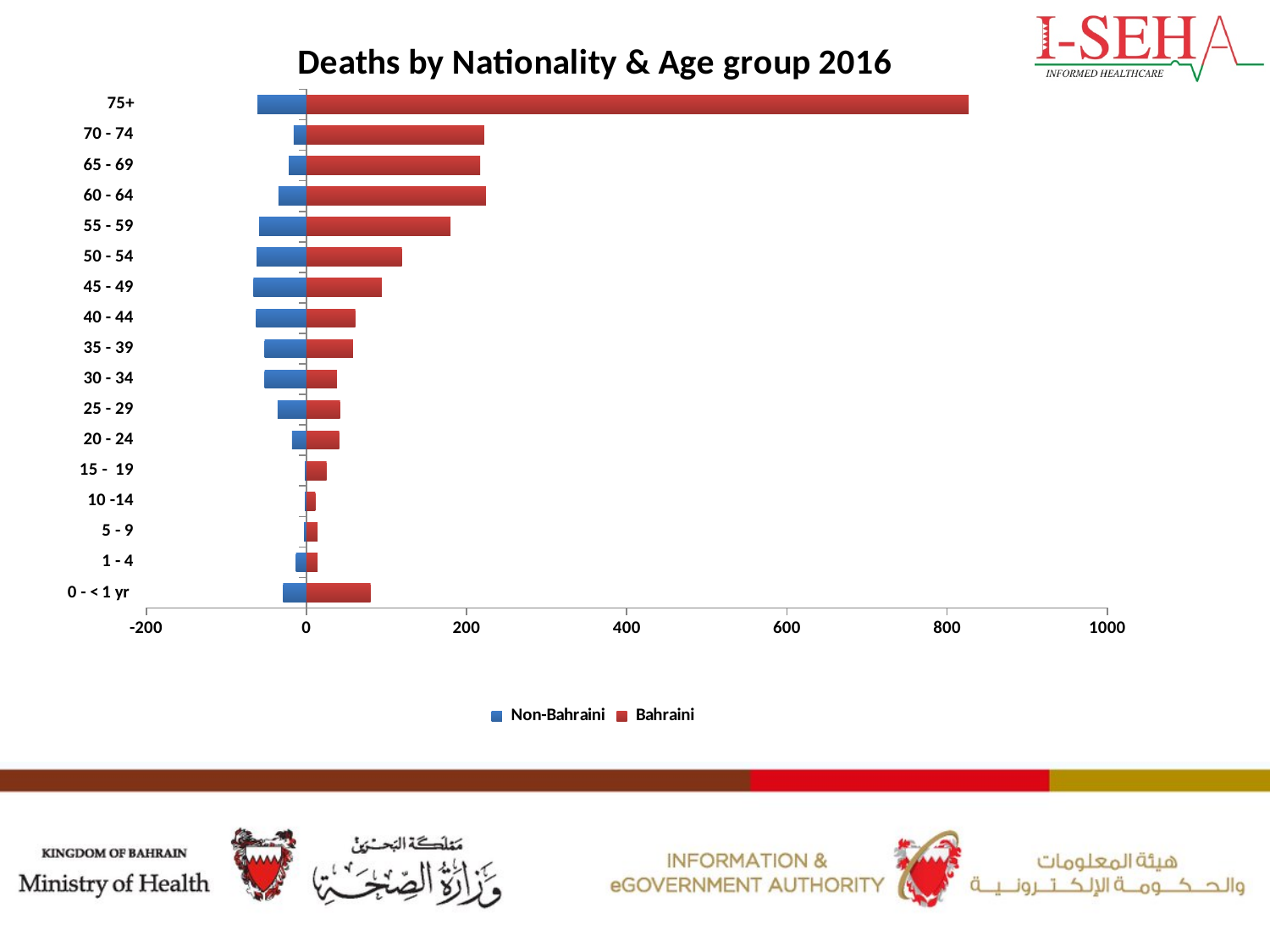
Is the Bahraini value for the 55 - 59 age group greater or less than 200? less What type of chart is shown on the slide? Bar chart Which has more Bahraini deaths, the 0 - < 1 yr age group or the 1 - 4 age group? 0 - < 1 yr How many age group categories are shown on the chart? 17 Is the Bahraini value for the 0 - < 1 yr age group greater or less than 200? less Is the Bahraini value for the 75+ age group greater or less than 800? greater How many series does the legend list? 2 Which has more Bahraini deaths, the 50 - 54 age group or the 45 - 49 age group? 50 - 54 What is the title of the chart? Deaths by Nationality & Age group 2016 What colour represents the Bahraini series in the chart? Red Which age group has the highest number of Bahraini deaths? 75+ Do Bahraini deaths generally rise or fall as the age group increases from 20 - 24 to 75+? rise